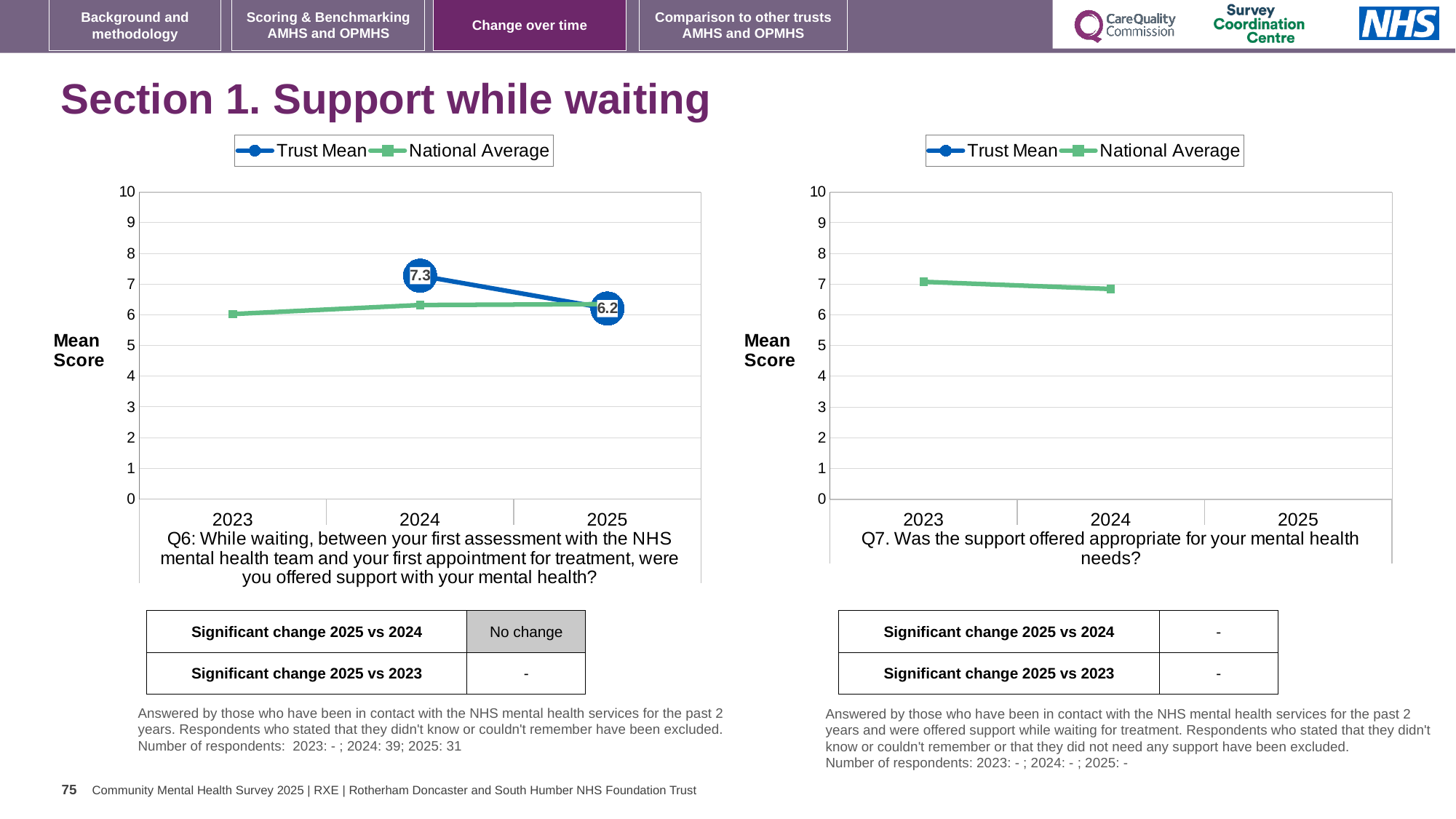
On the left chart (Q6), what is the Trust Mean score for 2025? 6.2 On the right chart (Q7), does the National Average rise or fall from 2023 to 2024? fall On the right chart (Q7), is the National Average for 2023 greater or less than 6? greater On the left chart (Q6), what is the Trust Mean score for 2024? 7.3 On the left chart (Q6), does the Trust Mean rise or fall from 2024 to 2025? fall On the left chart (Q6), is the National Average for 2023 greater or less than 7? less On the left chart (Q6), by how much did the Trust Mean fall from 2024 to 2025? 1.1 How many series does the legend of the left chart (Q6) list? 2 On the left chart (Q6), in 2024, which is larger: the Trust Mean or the National Average? Trust Mean What are the two series named in the legend of the right chart (Q7)? Trust Mean and National Average How many years are shown on the x axis of the right chart (Q7)? 3 What kind of chart is the left chart (Q6)? line chart